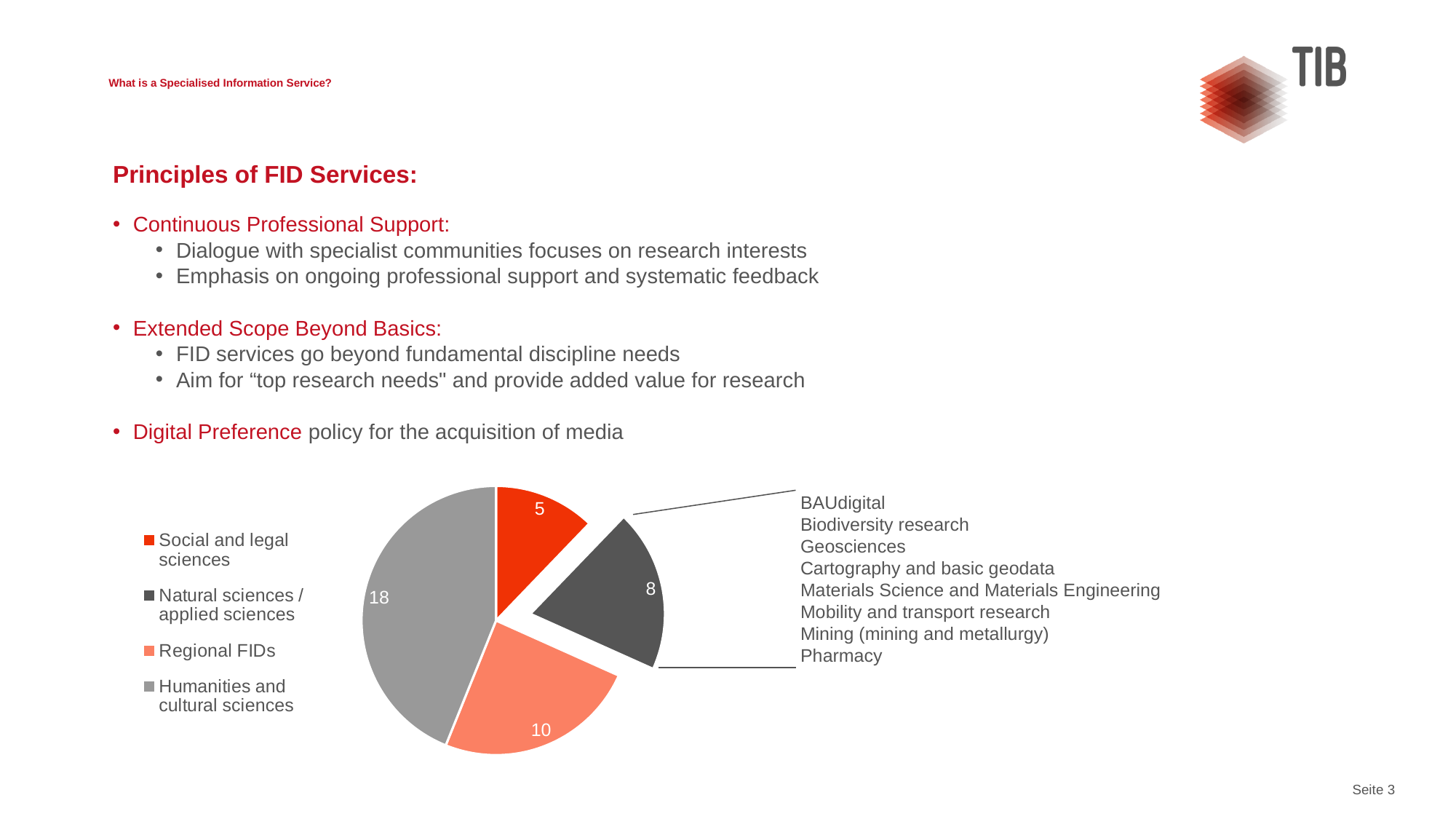
What is the value for Natural sciences / applied sciences in the pie chart? 8 Which category has the smallest slice in the pie chart? Social and legal sciences What is the value for Regional FIDs in the pie chart? 10 What kind of chart is shown on the slide? pie chart How many slices does the pie chart have? 4 Which is larger in the pie chart: Regional FIDs or Natural sciences / applied sciences? Regional FIDs What is the value for Social and legal sciences in the pie chart? 5 What is the difference between the values for Humanities and cultural sciences and Regional FIDs? 8 What is the value for Humanities and cultural sciences in the pie chart? 18 Which colour represents Regional FIDs in the pie chart legend? light orange / salmon What is the total of all the values shown in the pie chart? 41 Which category has the largest slice in the pie chart? Humanities and cultural sciences